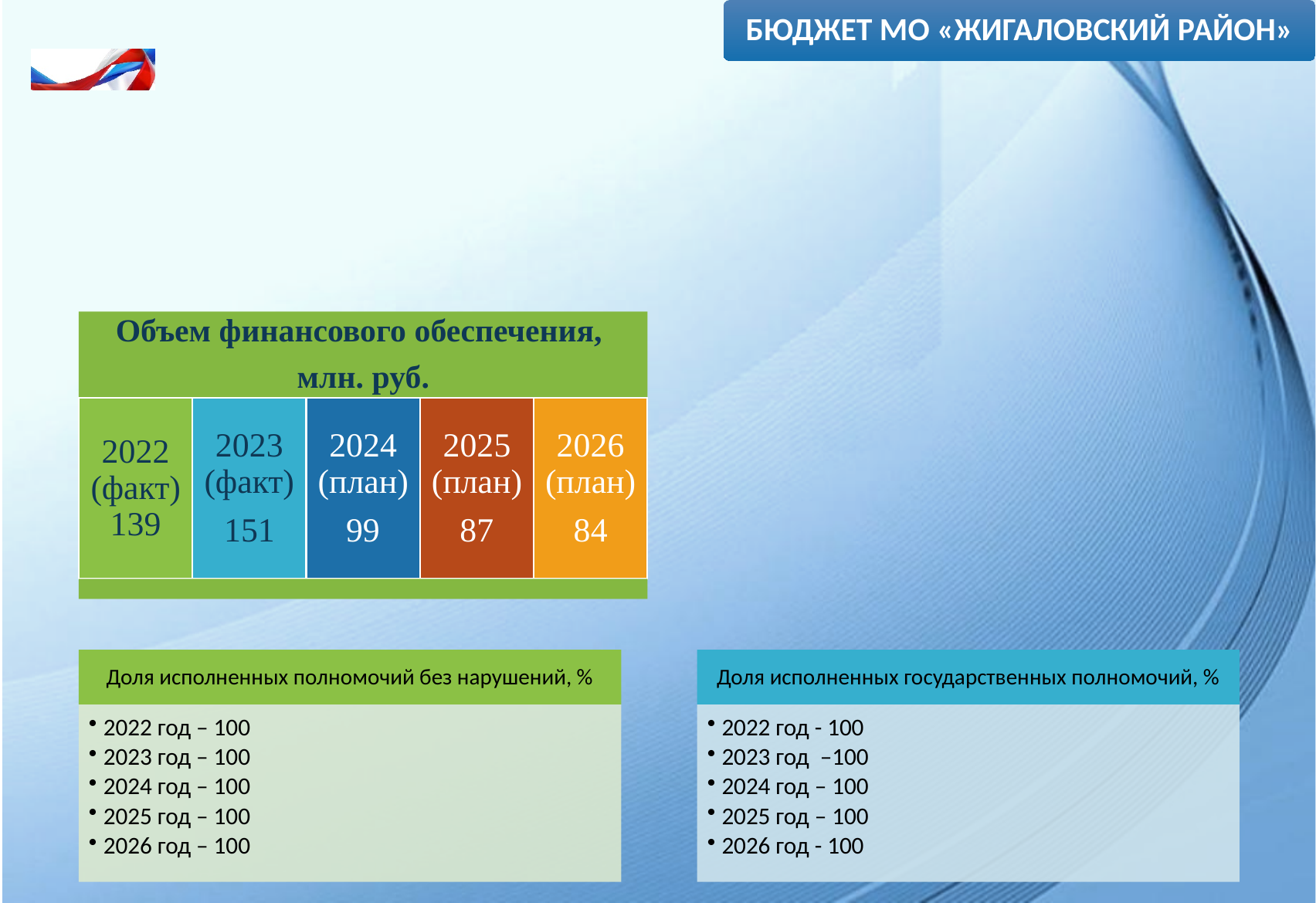
In the 'Объем финансового обеспечения, млн. руб.' graphic, what is the difference between the 2023 (факт) and 2024 (план) values? 52 In the 'Объем финансового обеспечения, млн. руб.' graphic, which year has the lowest value? 2026 (план) In the 'Объем финансового обеспечения, млн. руб.' graphic, do the values rise or fall from 2023 (факт) to 2026 (план)? fall In the 'Объем финансового обеспечения, млн. руб.' graphic, what is the value for 2023 (факт)? 151 In the 'Объем финансового обеспечения, млн. руб.' graphic, which year has the highest value? 2023 (факт) In the 'Объем финансового обеспечения, млн. руб.' graphic, what is the value for 2026 (план)? 84 In the 'Объем финансового обеспечения, млн. руб.' graphic, what is the difference between the 2025 (план) and 2026 (план) values? 3 In the 'Объем финансового обеспечения, млн. руб.' graphic, which is larger: the value for 2022 (факт) or 2025 (план)? 2022 (факт) How many years are shown in the 'Объем финансового обеспечения, млн. руб.' graphic? 5 What unit is stated in the title of the 'Объем финансового обеспечения' graphic? млн. руб. In the 'Объем финансового обеспечения, млн. руб.' graphic, what is the value for 2024 (план)? 99 In the 'Объем финансового обеспечения, млн. руб.' graphic, what is the value for 2022 (факт)? 139